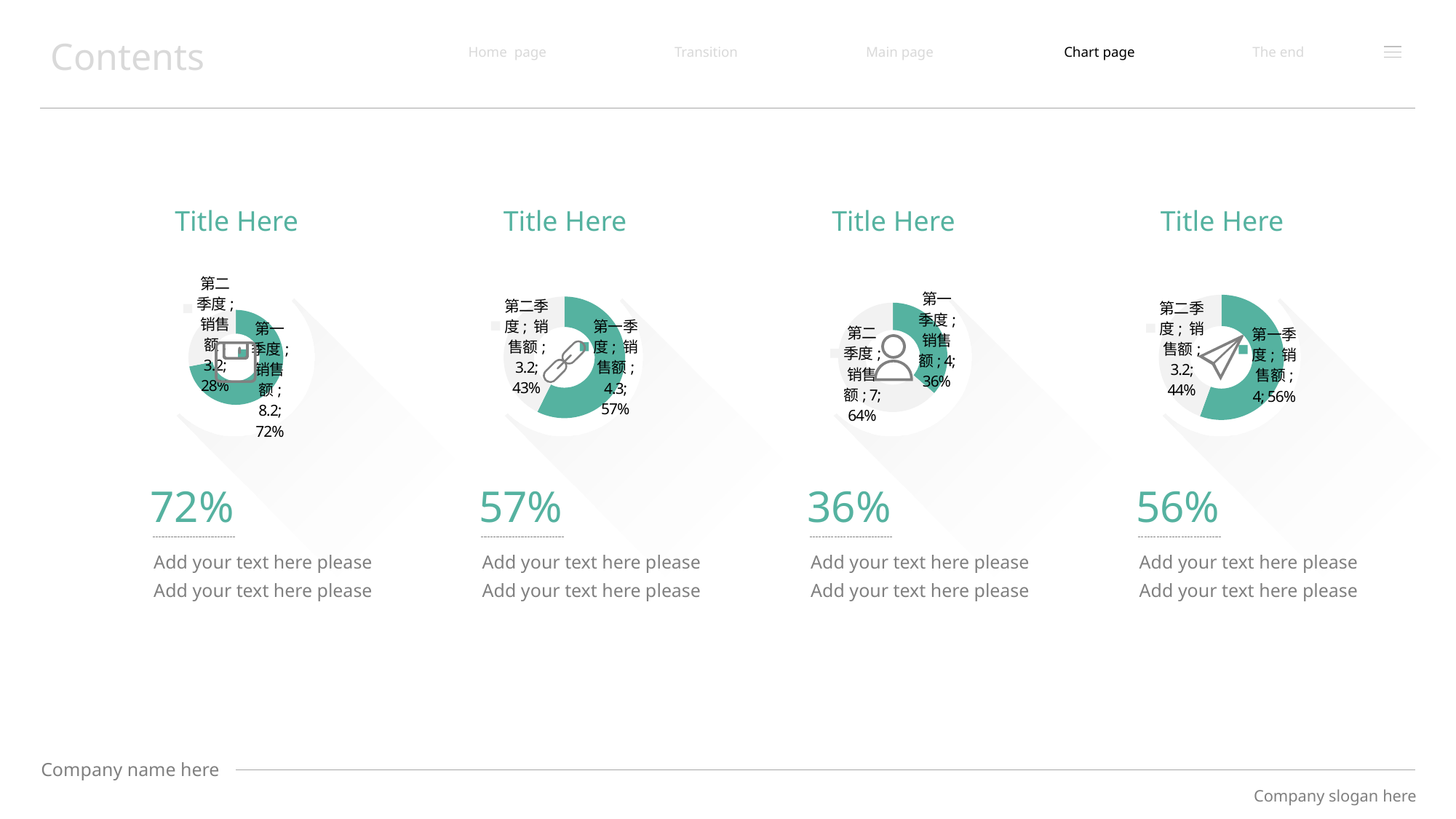
How many doughnut charts are shown on the slide? 4 How many slices does the third chart from the left have? 2 In the leftmost doughnut chart, what is the difference between the 第一季度 value and the 第二季度 value? 5 In the second chart from the left, what percentage share does 第二季度 have? 43% In the leftmost doughnut chart, what percentage share does 第二季度 (second quarter) have? 28% In the rightmost doughnut chart, what percentage share does 第一季度 have? 56% In the second chart from the left, what value is shown for 第一季度 销售额? 4.3 In the third chart from the left, what value is shown for 第二季度 销售额? 7 In the third chart from the left, which quarter has the larger share, 第一季度 or 第二季度? 第二季度 What type of chart is used in each of the four panels on the slide? Doughnut (pie) chart In the leftmost doughnut chart, what value is shown for 第一季度 (first quarter) 销售额? 8.2 In the rightmost doughnut chart, what value is shown for 第二季度 销售额? 3.2